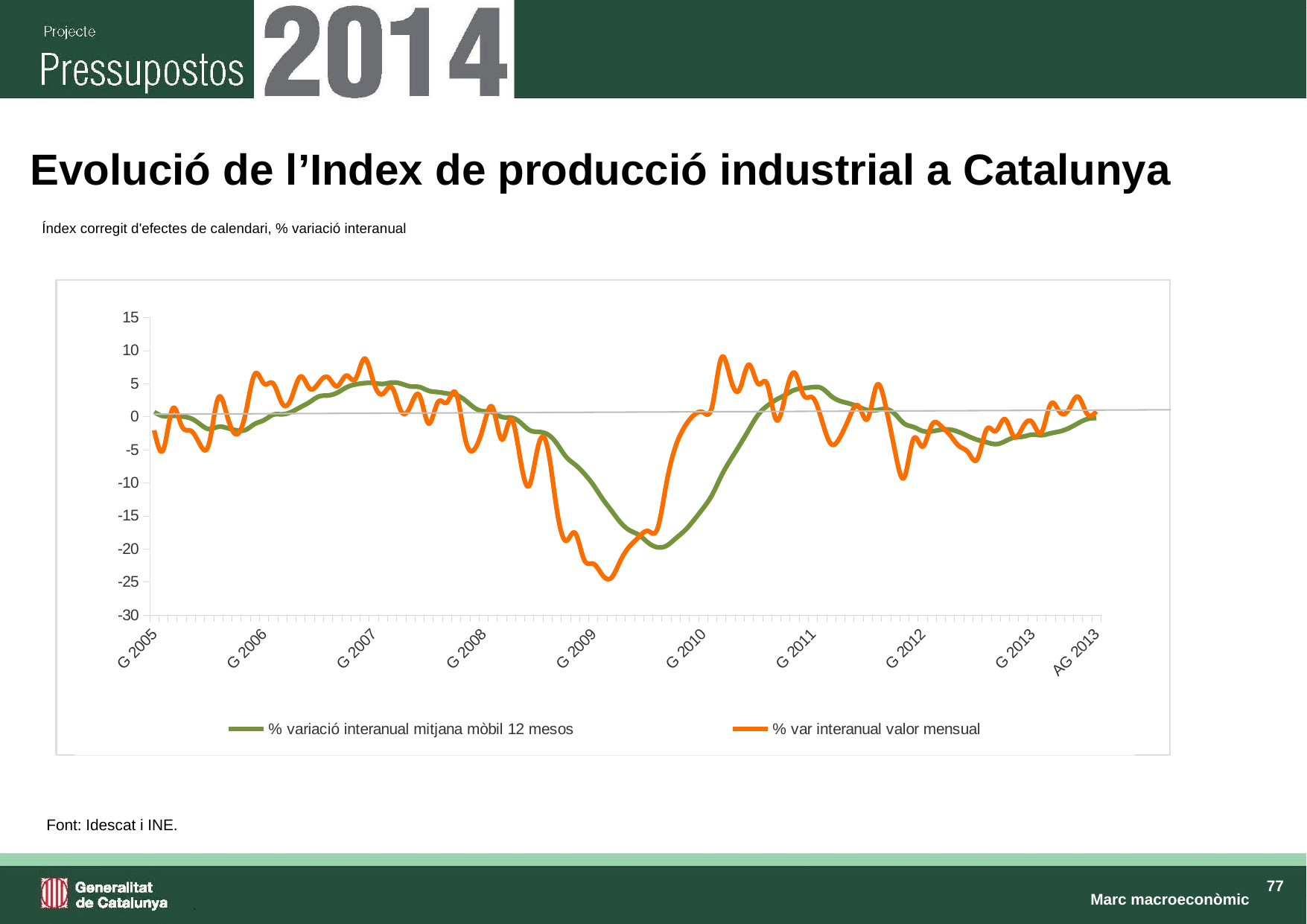
Is the lowest value of the '% var interanual valor mensual' series greater or less than -20? less How many labels are shown on the x axis? 10 What source is cited below the chart? Idescat i INE What is the title of the slide's chart? Evolució de l'Index de producció industrial a Catalunya How many series does the legend list? 2 What kind of chart is shown on the slide? line chart Which series reaches the lower minimum value, the 12-month moving average or the monthly value? % var interanual valor mensual Does the '% variació interanual mitjana mòbil 12 mesos' series rise or fall between G 2008 and G 2009? fall Is the lowest value of the '% variació interanual mitjana mòbil 12 mesos' series greater or less than -15? less Does the '% variació interanual mitjana mòbil 12 mesos' series rise or fall between G 2010 and G 2011? rise Is the highest value of the '% var interanual valor mensual' series greater or less than 5? greater Around which year label does the '% var interanual valor mensual' series reach its lowest point? G 2009